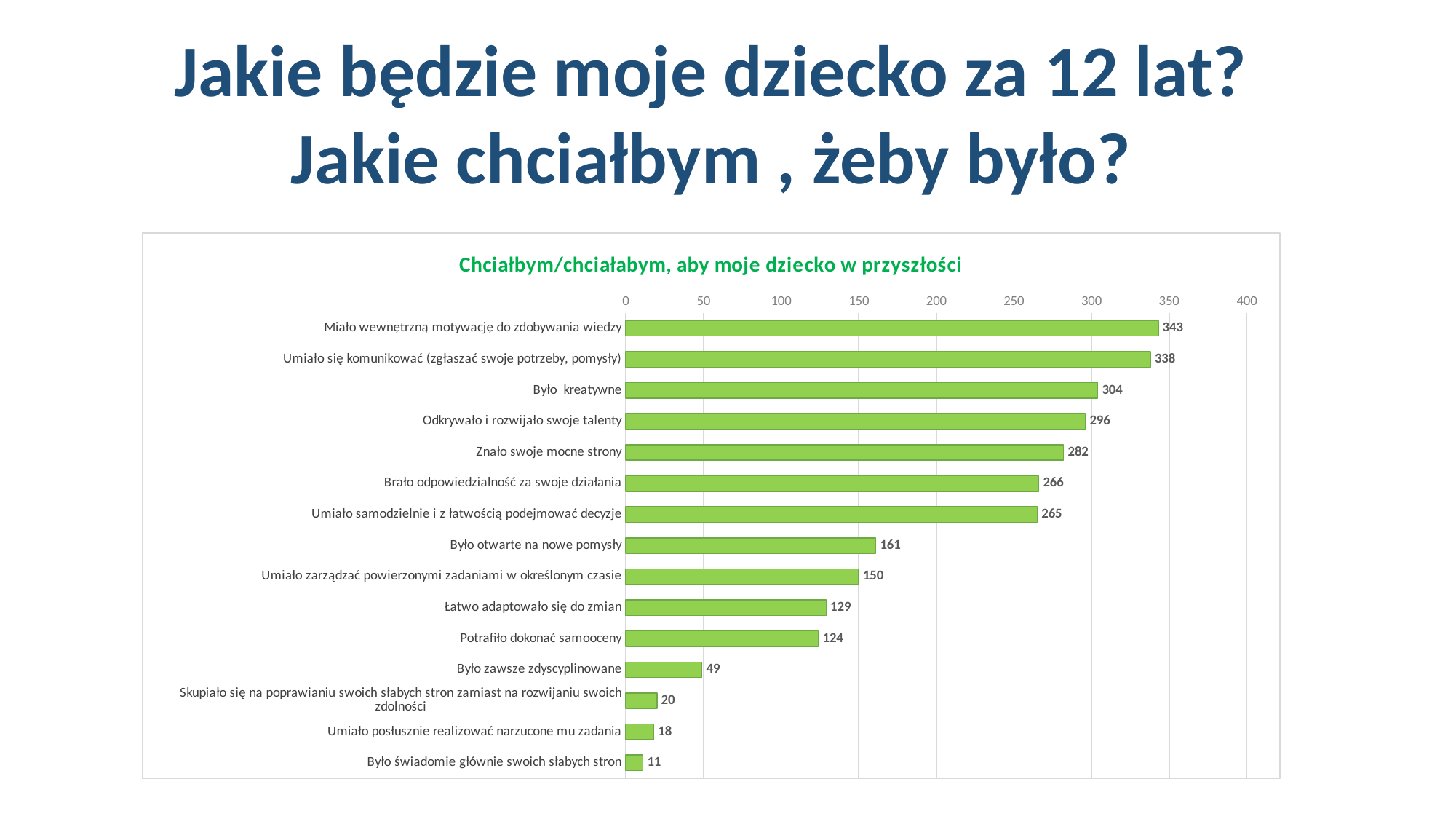
What is the title of the chart? Chciałbym/chciałabym, aby moje dziecko w przyszłości What is the value for "Było kreatywne"? 304 What is the difference between the values for "Znało swoje mocne strony" and "Brało odpowiedzialność za swoje działania"? 16 Which category has the highest value? Miało wewnętrzną motywację do zdobywania wiedzy What is the value for "Łatwo adaptowało się do zmian"? 129 What is the difference between the values for "Było zawsze zdyscyplinowane" and "Potrafiło dokonać samooceny"? 75 Which category has the lowest value? Było świadomie głównie swoich słabych stron Which is larger: the value for "Było otwarte na nowe pomysły" or for "Umiało zarządzać powierzonymi zadaniami w określonym czasie"? Było otwarte na nowe pomysły What kind of chart is shown on the slide? Bar chart What is the value for "Umiało posłusznie realizować narzucone mu zadania"? 18 Is the value for "Odkrywało i rozwijało swoje talenty" greater or less than 250? greater How many categories are shown in the chart? 15